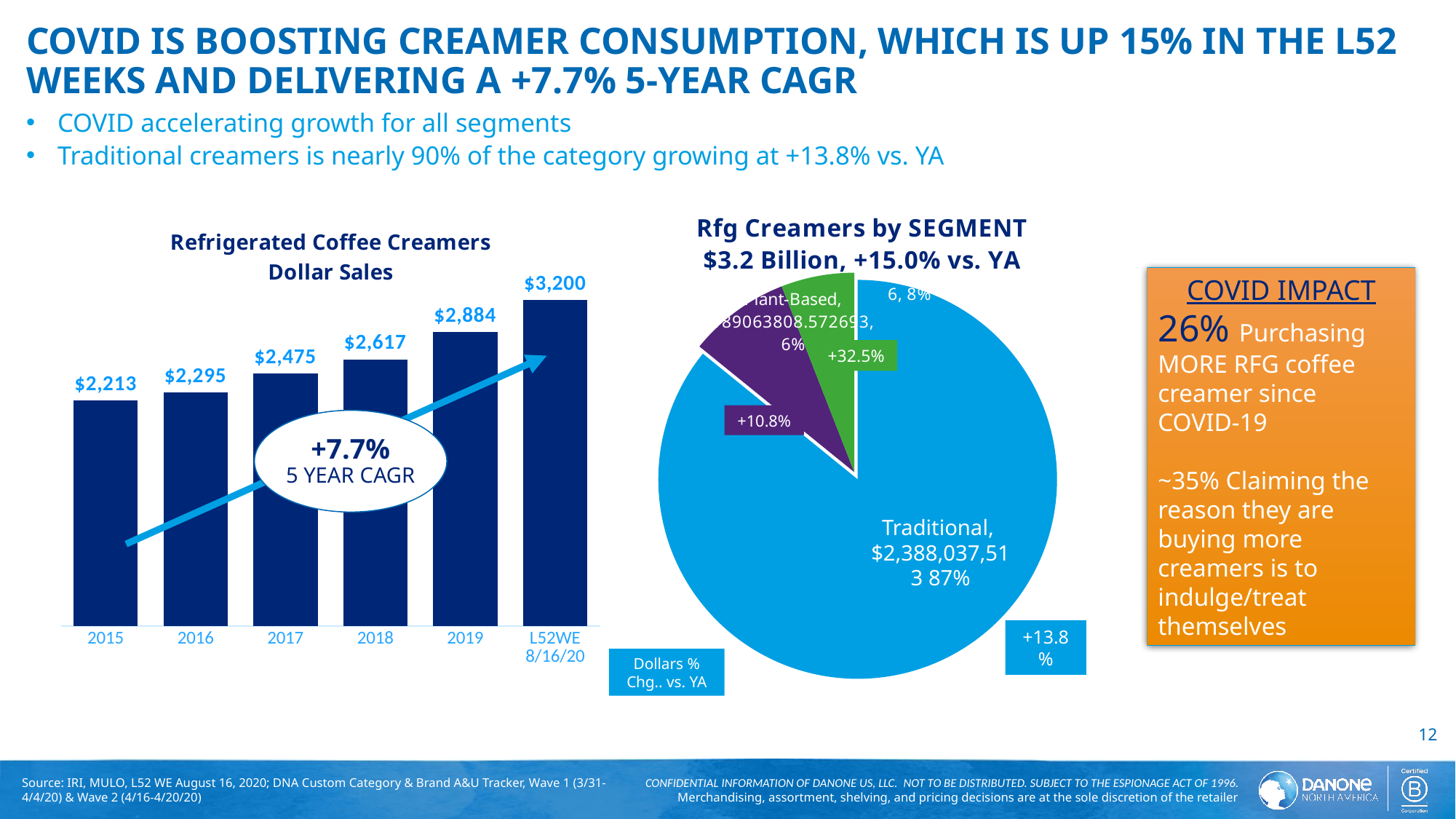
In the Refrigerated Coffee Creamers Dollar Sales chart, what is the value for L52WE 8/16/20? $3,200 In the Refrigerated Coffee Creamers Dollar Sales chart, which year has the lowest value? 2015 In the Refrigerated Coffee Creamers Dollar Sales chart, what is the value for 2015? $2,213 In the Refrigerated Coffee Creamers Dollar Sales chart, do the values rise or fall from 2015 to L52WE 8/16/20? Rise In the Refrigerated Coffee Creamers Dollar Sales chart, what is the difference between the 2018 and 2017 values? $142 How many bars are in the Refrigerated Coffee Creamers Dollar Sales chart? 6 In the Refrigerated Coffee Creamers Dollar Sales chart, what is the value for 2019? $2,884 What kind of chart is the Refrigerated Coffee Creamers Dollar Sales chart? Bar chart In the Rfg Creamers by SEGMENT pie chart, what share of the pie is the Traditional segment? 87% In the Refrigerated Coffee Creamers Dollar Sales chart, which period has the highest value? L52WE 8/16/20 What kind of chart is the Rfg Creamers by SEGMENT chart? Pie chart In the Refrigerated Coffee Creamers Dollar Sales chart, which is larger, the value for 2016 or the value for 2017? 2017